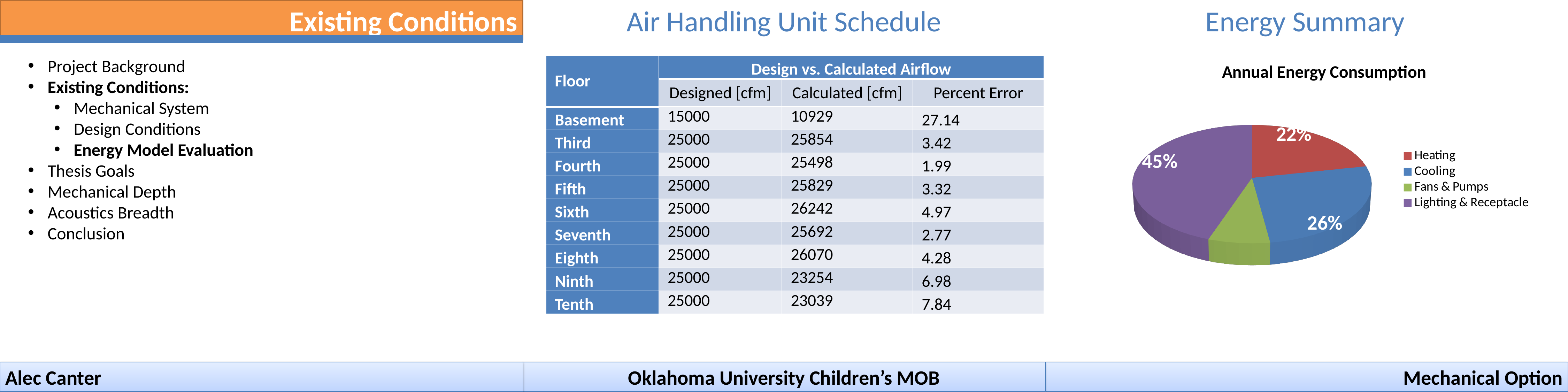
What kind of chart is shown under Energy Summary? pie chart What share of the pie chart does Lighting & Receptacle account for? 45% In the pie chart, which is larger, Cooling or Heating? Cooling How many categories does the legend of the Annual Energy Consumption pie chart list? 4 Which category has the largest slice in the Annual Energy Consumption pie chart? Lighting & Receptacle What percentage of annual energy consumption is Cooling in the pie chart? 26% What percentage of annual energy consumption is Heating in the pie chart? 22% What is the title of the pie chart? Annual Energy Consumption What colour is the Heating slice in the pie chart? red Which category has the smallest slice in the Annual Energy Consumption pie chart? Fans & Pumps In the pie chart, what is the difference between the Cooling and Heating shares? 4% In the pie chart, how many percentage points larger is Lighting & Receptacle than Cooling? 19%